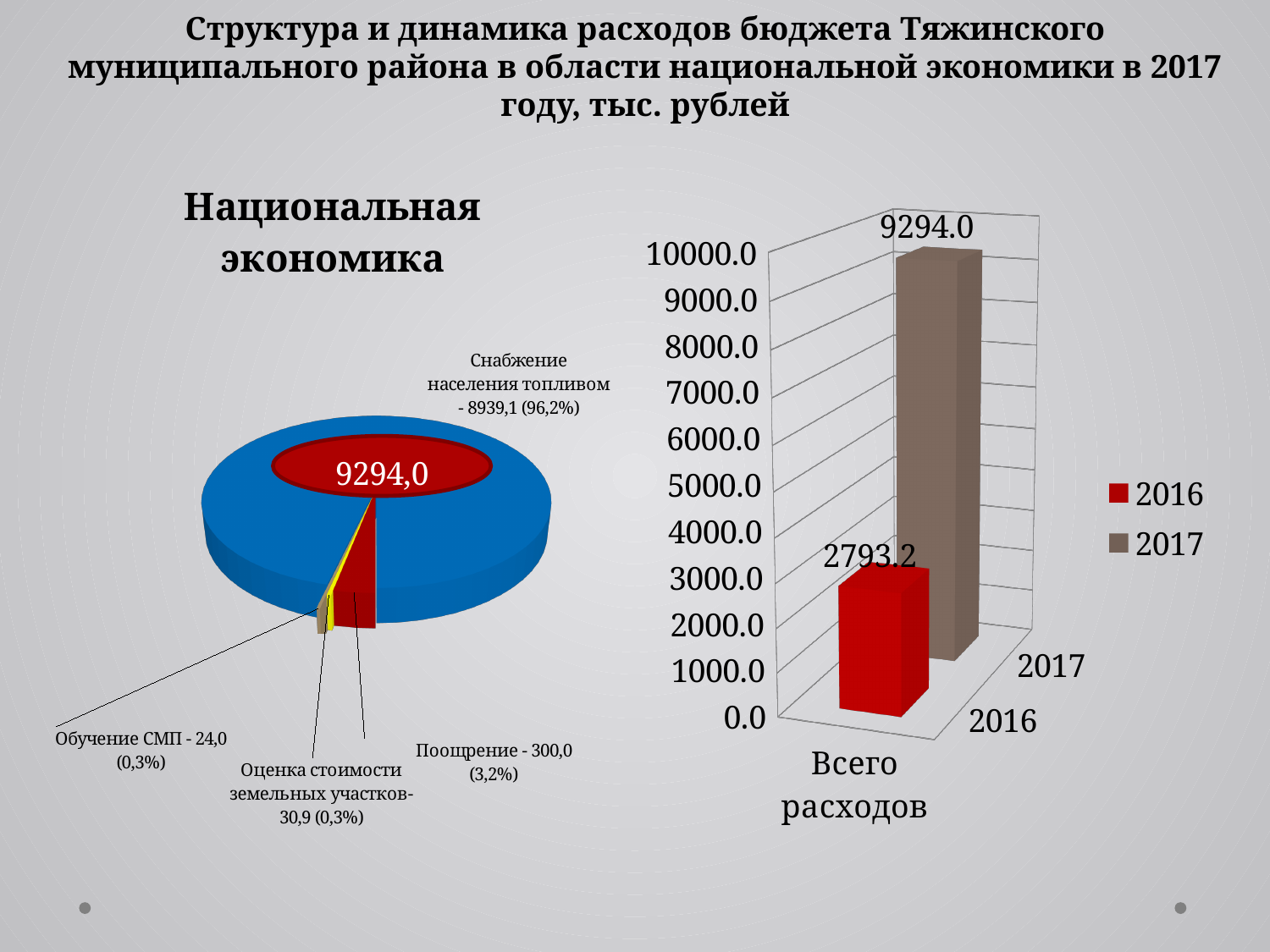
In the bar chart on the right, what is the value for 2016? 2793.2 In the pie chart "Национальная экономика", what total value is printed in the centre of the pie? 9294,0 In the pie chart "Национальная экономика", how many slices are labelled? 4 In the bar chart on the right, how many series does the legend list? 2 In the bar chart on the right, which year has the larger value, 2016 or 2017? 2017 In the pie chart "Национальная экономика", what is the value for "Обучение СМП"? 24,0 In the pie chart "Национальная экономика", which category has the largest slice? Снабжение населения топливом In the bar chart on the right, what is the value for 2017? 9294.0 In the bar chart on the right, what is the difference between the 2017 and 2016 values? 6500.8 In the pie chart "Национальная экономика", what is the value for "Оценка стоимости земельных участков"? 30,9 In the pie chart "Национальная экономика", what share of the pie does "Поощрение" represent? 3,2% In the pie chart "Национальная экономика", what is the value for "Снабжение населения топливом"? 8939,1